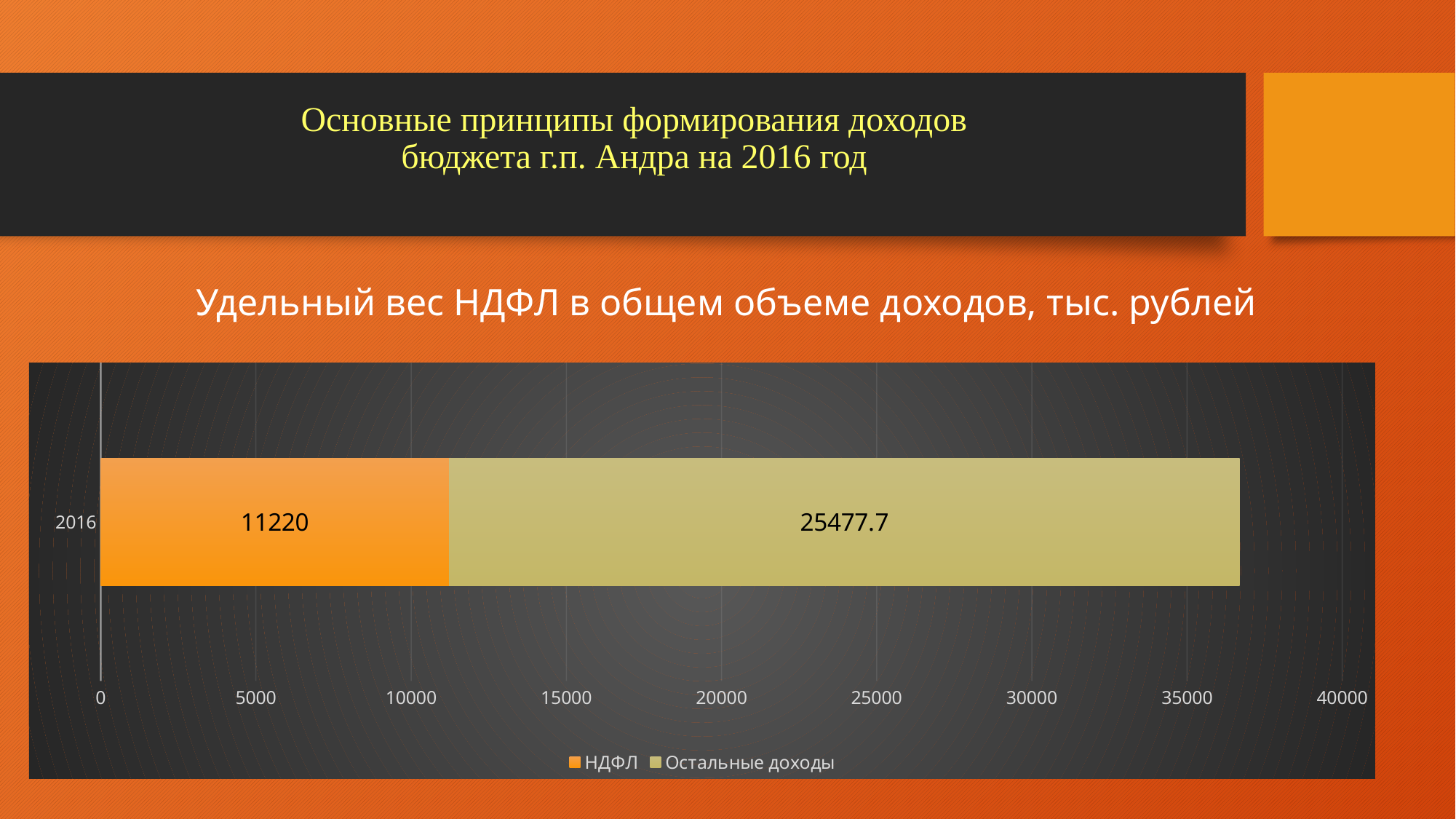
Is the value for НДФЛ greater or less than 15000? less Is the total of the 2016 bar greater or less than 35000? greater What is the value for Остальные доходы in 2016? 25477.7 Which series is shown in orange in the legend? НДФЛ Which series has the larger value in 2016, НДФЛ or Остальные доходы? Остальные доходы What is the difference between Остальные доходы and НДФЛ in 2016? 14257.7 What is the value for НДФЛ in 2016? 11220 What kind of chart is shown on the slide? Stacked bar chart What is the title of the chart? Удельный вес НДФЛ в общем объеме доходов, тыс. рублей What is the total of the stacked bar for 2016? 36697.7 How many categories are shown on the vertical axis? 1 How many series does the legend list? 2